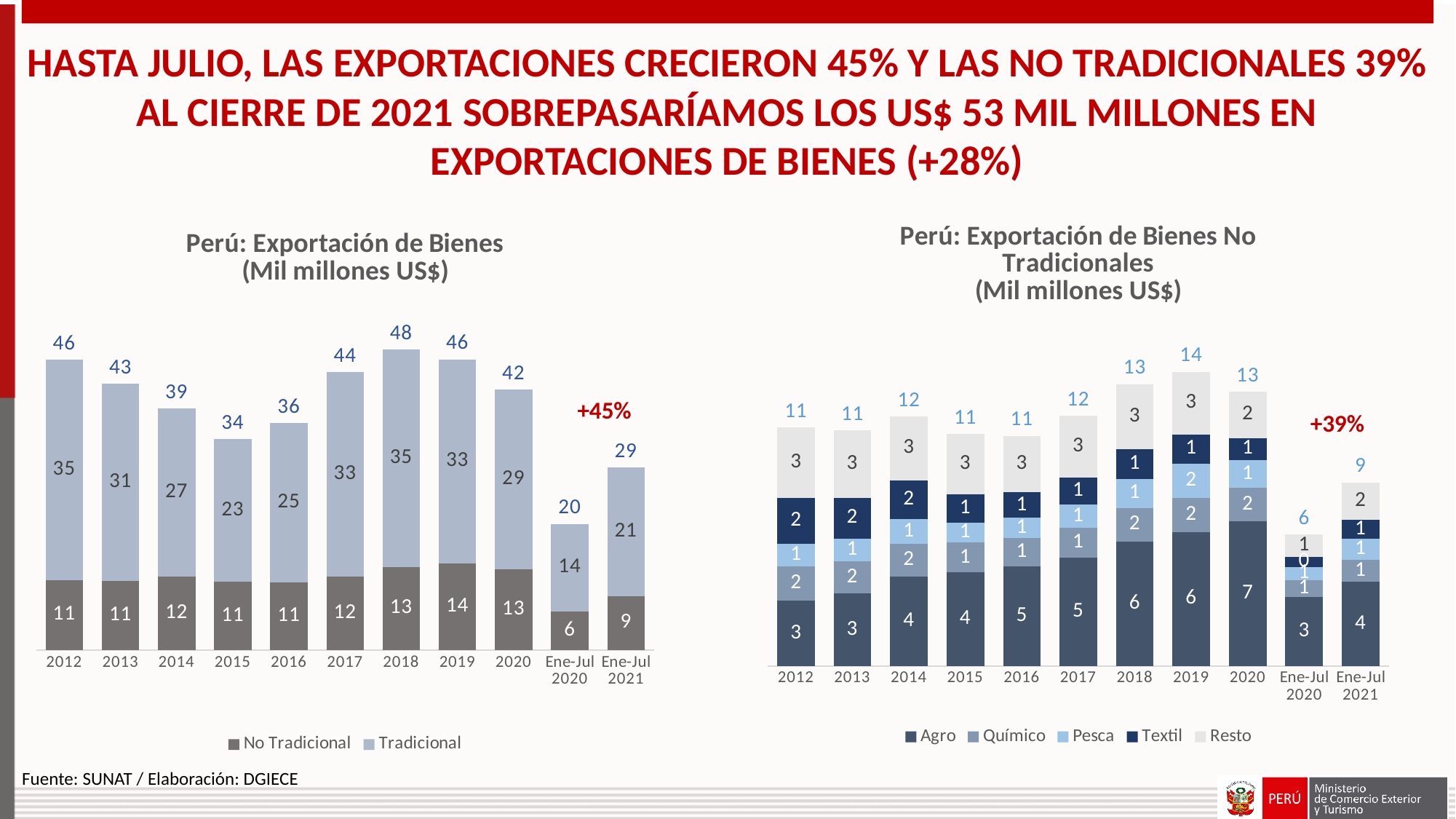
In the chart 'Perú: Exportación de Bienes No Tradicionales', what is the total for 2019? 14 In the chart 'Perú: Exportación de Bienes', how many series does the legend list? 2 What type of chart is 'Perú: Exportación de Bienes No Tradicionales'? stacked bar chart In the chart 'Perú: Exportación de Bienes No Tradicionales', what is the Agro value for 2020? 7 In the chart 'Perú: Exportación de Bienes', which year has the highest total? 2018 In the chart 'Perú: Exportación de Bienes', what percentage growth is annotated above the Ene-Jul 2021 bar? +45% In the chart 'Perú: Exportación de Bienes No Tradicionales', how many series does the legend list? 5 In the chart 'Perú: Exportación de Bienes No Tradicionales', is the Agro value for 2019 larger or smaller than the Agro value for 2015? larger In the chart 'Perú: Exportación de Bienes', what is the total value for 2018? 48 In the chart 'Perú: Exportación de Bienes', what is the Tradicional value for 2017? 33 In the chart 'Perú: Exportación de Bienes No Tradicionales', which period has the lowest total? Ene-Jul 2020 In the chart 'Perú: Exportación de Bienes', what is the difference between the totals for Ene-Jul 2021 and Ene-Jul 2020? 9